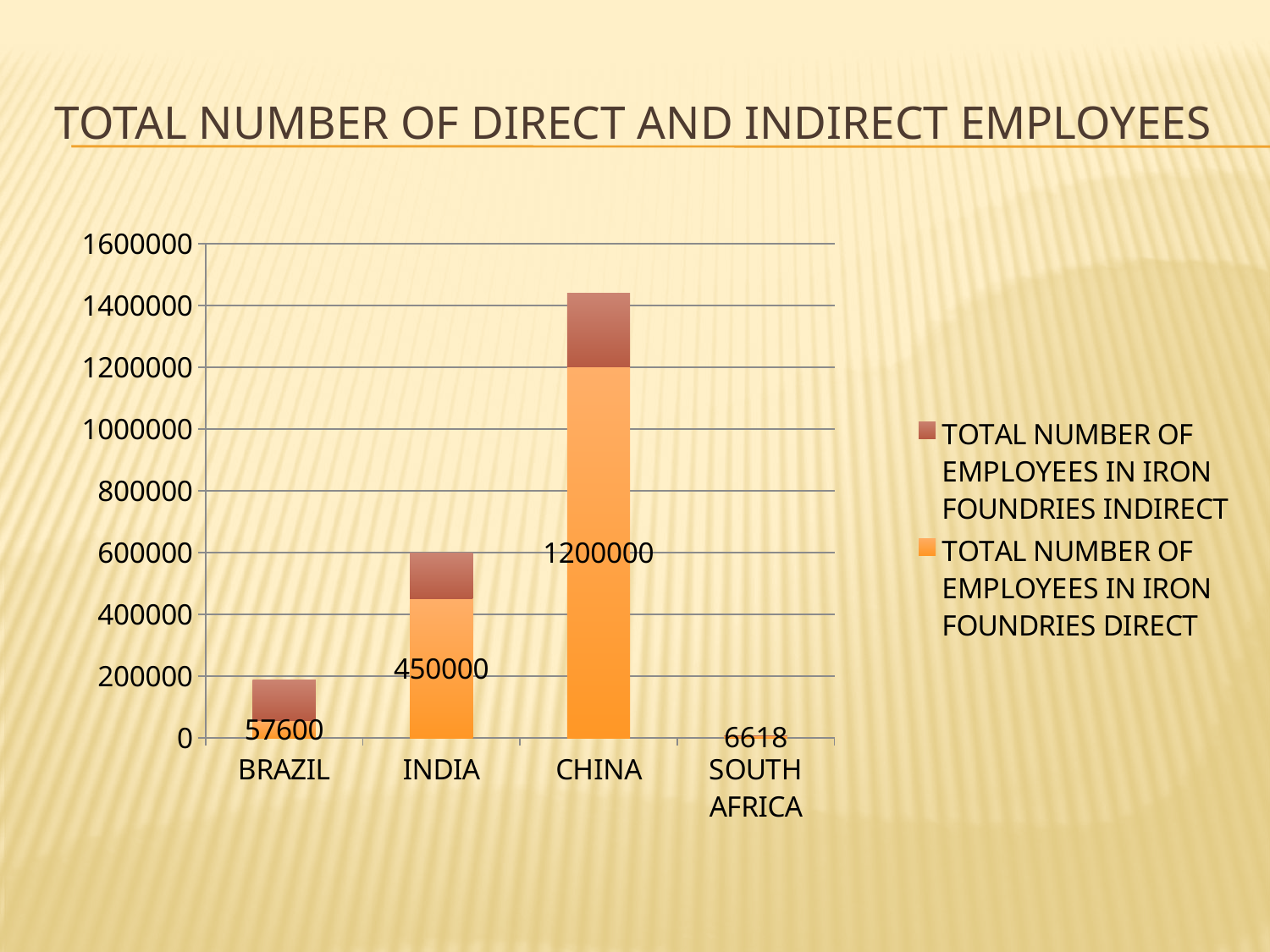
What is the value for the direct employees series for BRAZIL? 57600 Which country has the highest number of direct employees in iron foundries? CHINA What is the value for the direct employees series for INDIA? 450000 What is the value for the direct employees series for SOUTH AFRICA? 6618 How many countries are shown on the x axis? 4 Which country has the lowest number of direct employees in iron foundries? SOUTH AFRICA Is the total stacked bar height for CHINA greater or less than 1400000? greater What is the value for the direct employees series for CHINA? 1200000 What kind of chart is shown on the slide? Stacked bar chart Which has more direct employees in iron foundries, BRAZIL or INDIA? INDIA How many series does the legend list? 2 What is the difference between the direct employee values for CHINA and INDIA? 750000